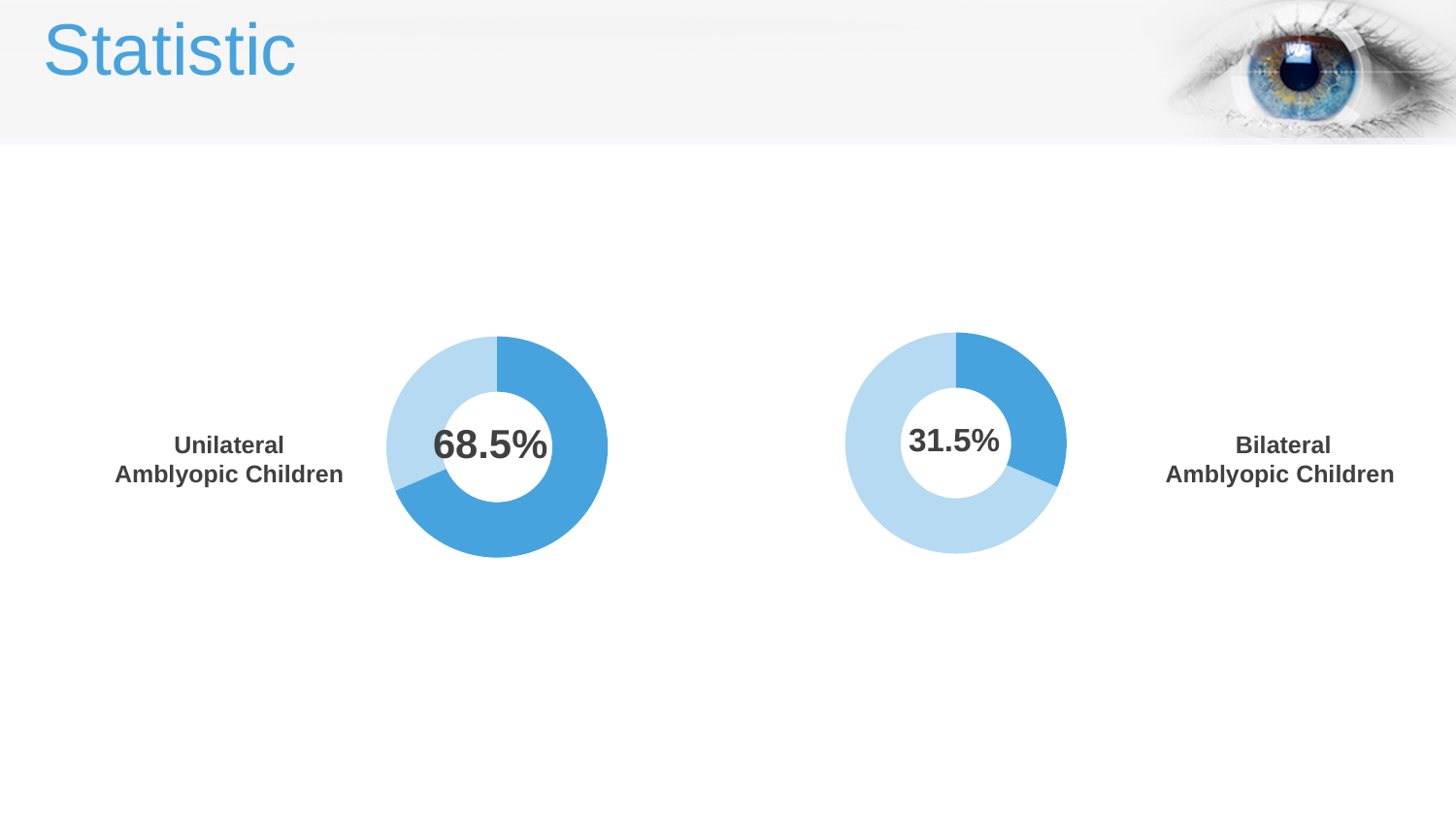
What is the title of the slide containing the two donut charts? Statistic What percentage is shown in the donut chart for Bilateral Amblyopic Children? 31.5% What percentage is shown in the donut chart for Unilateral Amblyopic Children? 68.5% What kind of chart is used to show the Unilateral Amblyopic Children percentage? Donut (pie) chart Which group has the smaller percentage, Unilateral Amblyopic Children or Bilateral Amblyopic Children? Bilateral Amblyopic Children Is the value for Unilateral Amblyopic Children greater or less than 50%? greater In the Bilateral Amblyopic Children donut chart, is the 31.5% segment shown in the darker or lighter blue? Darker blue Which group has the larger percentage, Unilateral Amblyopic Children or Bilateral Amblyopic Children? Unilateral Amblyopic Children What is the difference between the Unilateral Amblyopic Children percentage and the Bilateral Amblyopic Children percentage? 37% Is the value for Bilateral Amblyopic Children greater or less than 50%? less What do the Unilateral and Bilateral Amblyopic Children percentages add up to? 100% How many donut charts are on the slide? 2